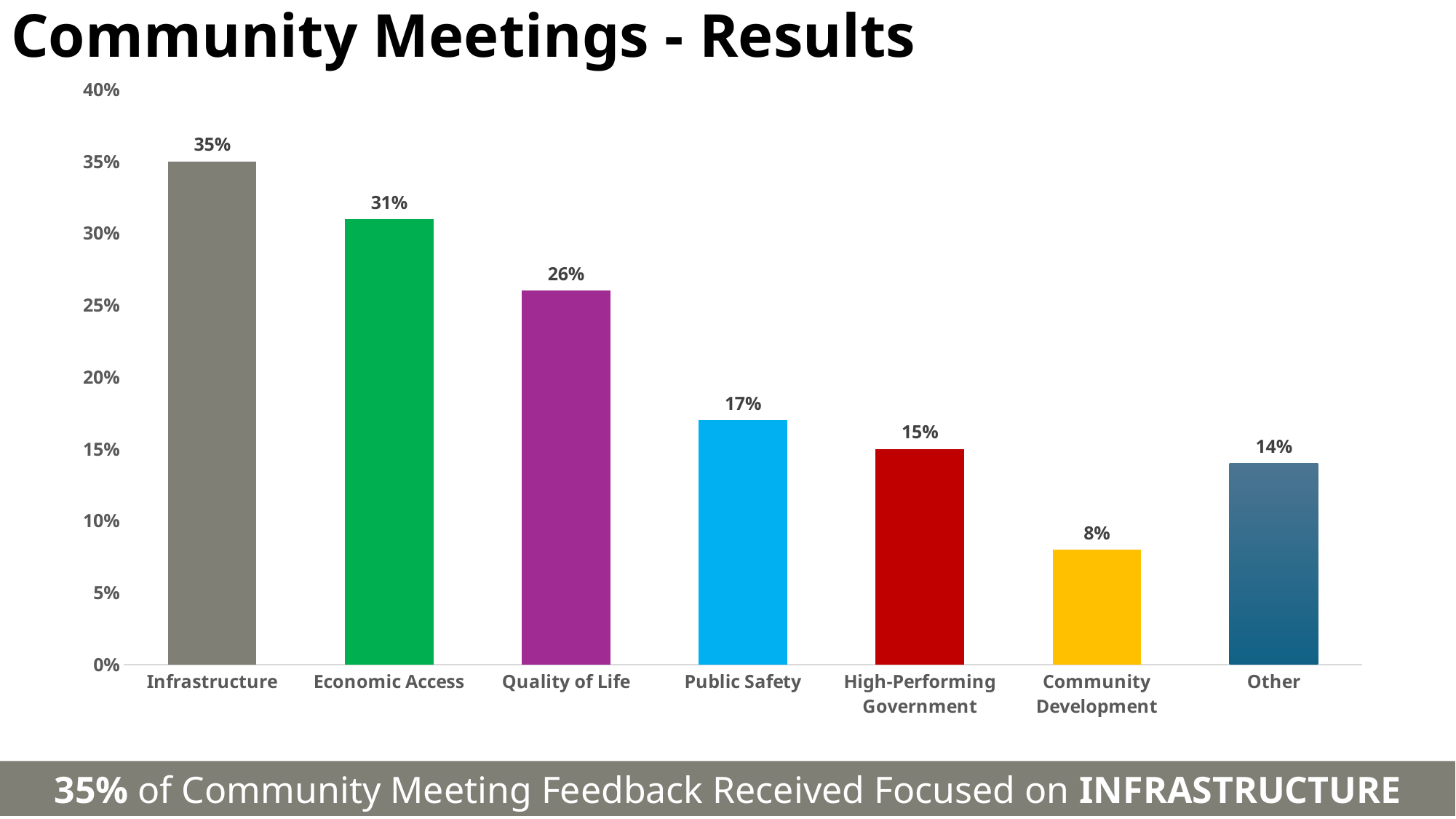
Which category has the highest value? Infrastructure What is the difference between the values for Public Safety and Community Development? 9% What is the difference between the values for Infrastructure and Economic Access? 4% What is the value for Community Development? 8% What is the value for Infrastructure? 35% What is the value for Other? 14% Is the value for Economic Access greater or less than 30%? greater Which category has the lowest value? Community Development What is the value for Quality of Life? 26% Which is larger, the value for High-Performing Government or the value for Other? High-Performing Government How many categories are shown on the x axis? 7 What kind of chart is shown on the slide? bar chart